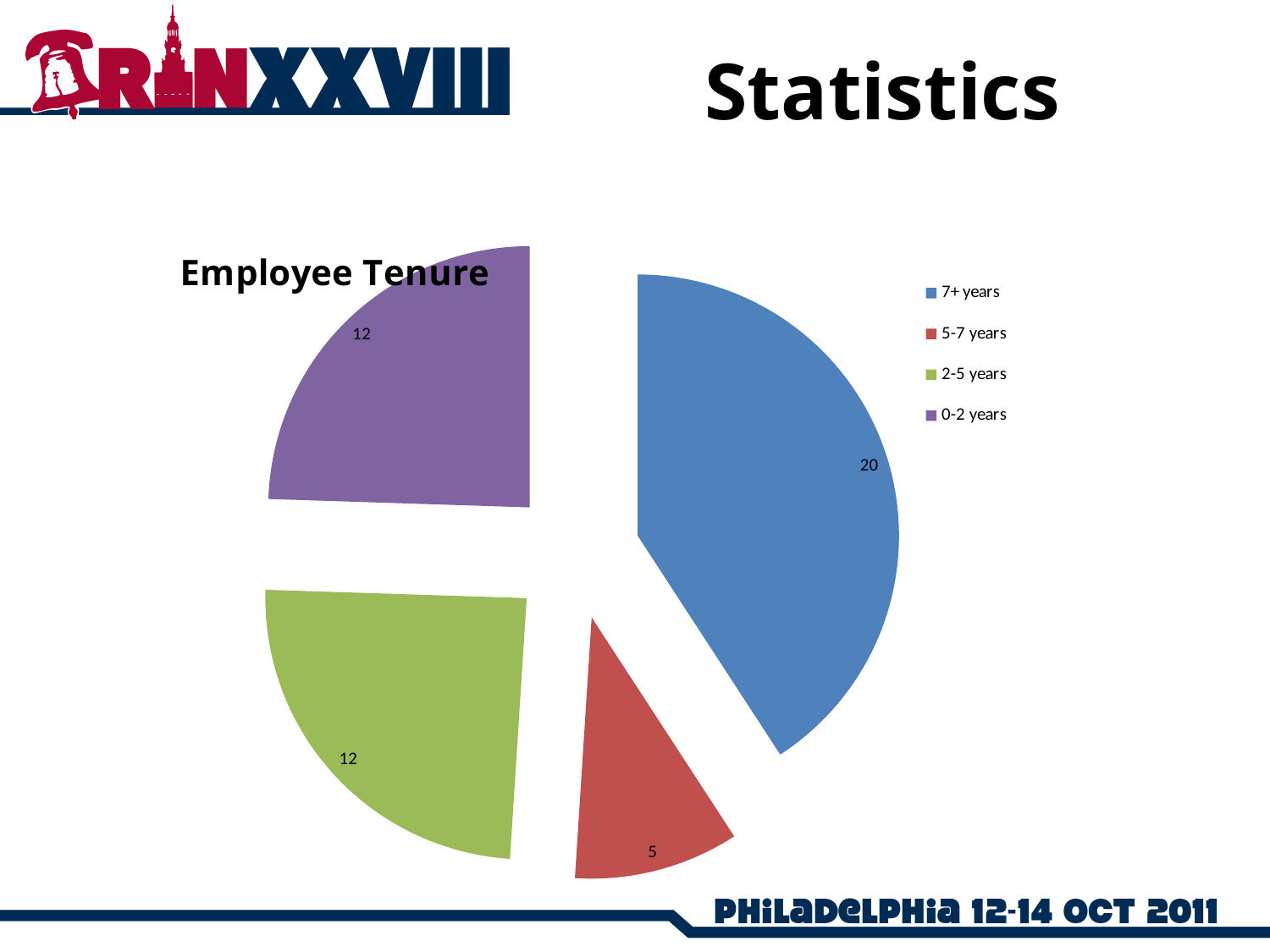
What is the value for the 2-5 years slice in the Employee Tenure pie chart? 12 How many slices does the Employee Tenure pie chart have? 4 Which is larger in the Employee Tenure pie chart, the 7+ years slice or the 2-5 years slice? 7+ years Which tenure category has the largest slice in the Employee Tenure pie chart? 7+ years What colour is the 7+ years slice in the Employee Tenure pie chart? Blue What kind of chart is used to show Employee Tenure? Pie chart What is the value for the 0-2 years slice in the Employee Tenure pie chart? 12 What is the value for the 7+ years slice in the Employee Tenure pie chart? 20 How many entries does the legend of the Employee Tenure chart list? 4 What is the difference between the 7+ years value and the 5-7 years value in the Employee Tenure pie chart? 15 Which tenure category has the smallest slice in the Employee Tenure pie chart? 5-7 years What is the value for the 5-7 years slice in the Employee Tenure pie chart? 5